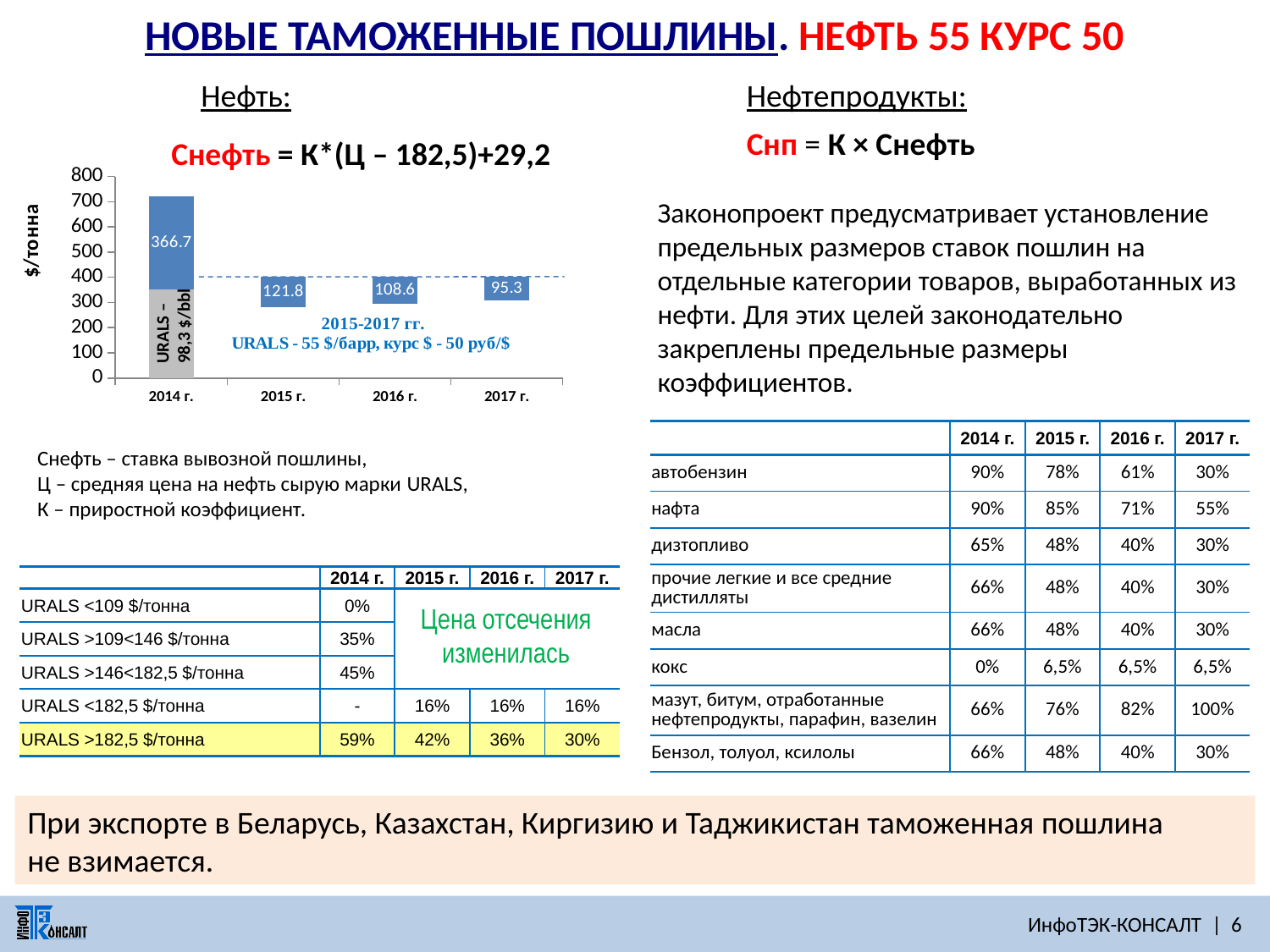
How many years are shown on the x axis of the Нефть chart? 4 Which year has the tallest bar in the Нефть chart? 2014 г. What is the value of the blue segment for 2015 г. in the Нефть chart? 121.8 In the Нефть chart, which is larger: the value for 2015 г. or for 2016 г.? 2015 г. In the Нефть chart, what is the difference between the 2015 г. value (121.8) and the 2017 г. value (95.3)? 26.5 What is the value printed on the blue segment for 2014 г. in the Нефть chart? 366.7 What is the value of the blue segment for 2017 г. in the Нефть chart? 95.3 Which year has the shortest bar in the Нефть chart? 2017 г. What kind of chart is the Нефть chart? bar chart What is the label on the vertical axis of the Нефть chart? $/тонна In the Нефть chart, is the total height of the 2014 г. bar greater or less than 600? greater What is the value of the blue segment for 2016 г. in the Нефть chart? 108.6